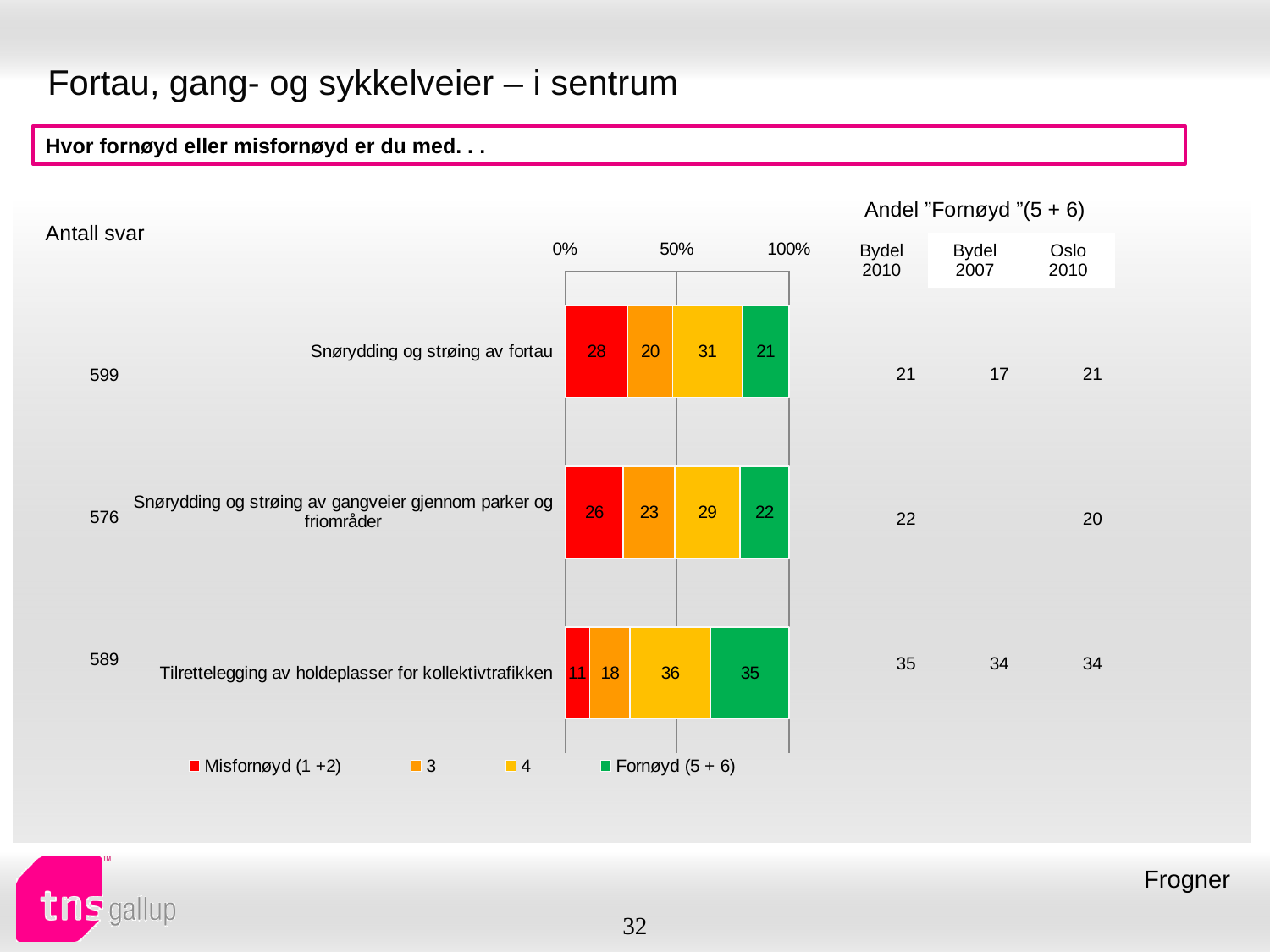
Which category has the highest "Fornøyd (5 + 6)" value? Tilrettelegging av holdeplasser for kollektivtrafikken What is the total of the stacked bar for "Snørydding og strøing av fortau"? 100 What is the first entry in the chart legend? Misfornøyd (1 +2) Which category has the lowest "Misfornøyd (1 +2)" value? Tilrettelegging av holdeplasser for kollektivtrafikken How many categories are shown in the bar chart? 3 What is the difference between the "Misfornøyd (1 +2)" values for "Snørydding og strøing av fortau" and "Tilrettelegging av holdeplasser for kollektivtrafikken"? 17 How many series does the legend list? 4 What kind of chart is shown on the slide? Stacked bar chart What is the value of the "3" segment for "Snørydding og strøing av gangveier gjennom parker og friområder"? 23 Which category has the larger "4" segment: "Snørydding og strøing av fortau" or "Snørydding og strøing av gangveier gjennom parker og friområder"? Snørydding og strøing av fortau What is the value of the "Misfornøyd (1 +2)" segment for "Snørydding og strøing av fortau"? 28 What is the value of the "Fornøyd (5 + 6)" segment for "Tilrettelegging av holdeplasser for kollektivtrafikken"? 35